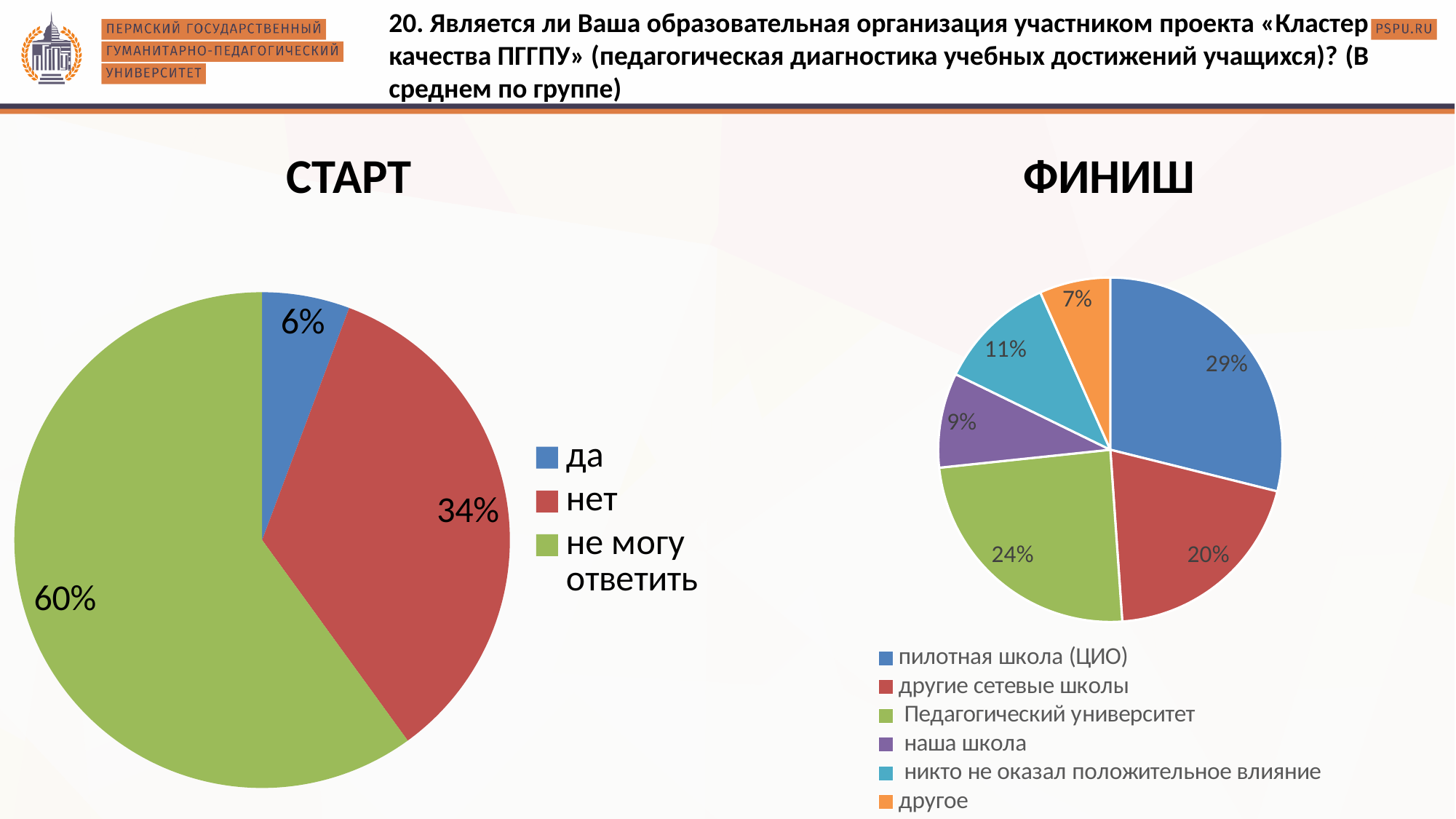
What type of chart is the СТАРТ chart? pie chart In the ФИНИШ chart, what share is shown for «пилотная школа (ЦИО)»? 29% In the СТАРТ chart, which answer has the largest share? не могу ответить In the ФИНИШ chart, what share is shown for «наша школа»? 9% In the СТАРТ chart, what share of respondents answered «нет»? 34% In the ФИНИШ chart, which category has the smallest share? другое How many categories does the legend of the ФИНИШ chart list? 6 In the ФИНИШ chart, which is larger: «другие сетевые школы» or «Педагогический университет»? Педагогический университет In the СТАРТ chart, what share of respondents answered «да»? 6% In the ФИНИШ chart, what is the difference in percentage points between «пилотная школа (ЦИО)» and «никто не оказал положительное влияние»? 18 In the СТАРТ chart, which answer has the smallest share? да In the СТАРТ chart, what is the difference in percentage points between «не могу ответить» and «нет»? 26